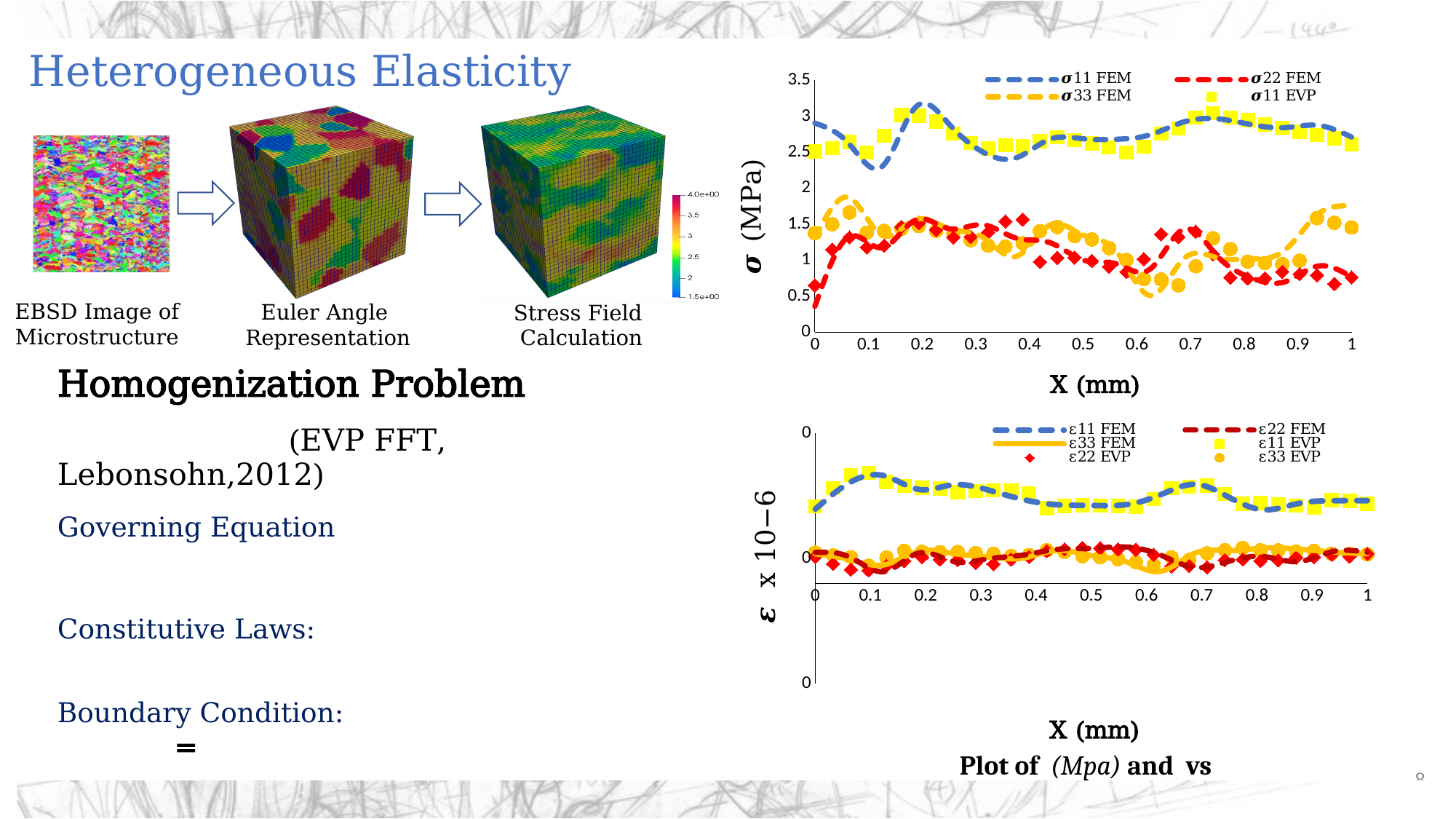
In the top chart (σ vs X), which is larger at X = 0.5: σ11 FEM or σ22 FEM? σ11 FEM What is the y-axis label of the top chart? σ (MPa) What is the x-axis label of the top chart (σ vs X)? X (mm) In the top chart (σ vs X), is the value of σ11 FEM at X = 0.5 greater or less than 2? greater What kind of chart is the top chart on the slide (σ vs X)? line chart In the top chart (σ vs X), is the value of σ22 FEM at X = 0 greater or less than 0.5? less In the top chart (σ vs X), is the value of σ11 FEM at X = 0 greater or less than 2.5? greater How many series does the legend of the top chart (σ vs X) list? 4 How many series does the legend of the bottom chart (ε vs X) list? 6 In the bottom chart (ε vs X), which FEM series lies highest across the X range? ε11 FEM In the top chart (σ vs X), which FEM series has the highest values across the X range? σ11 FEM